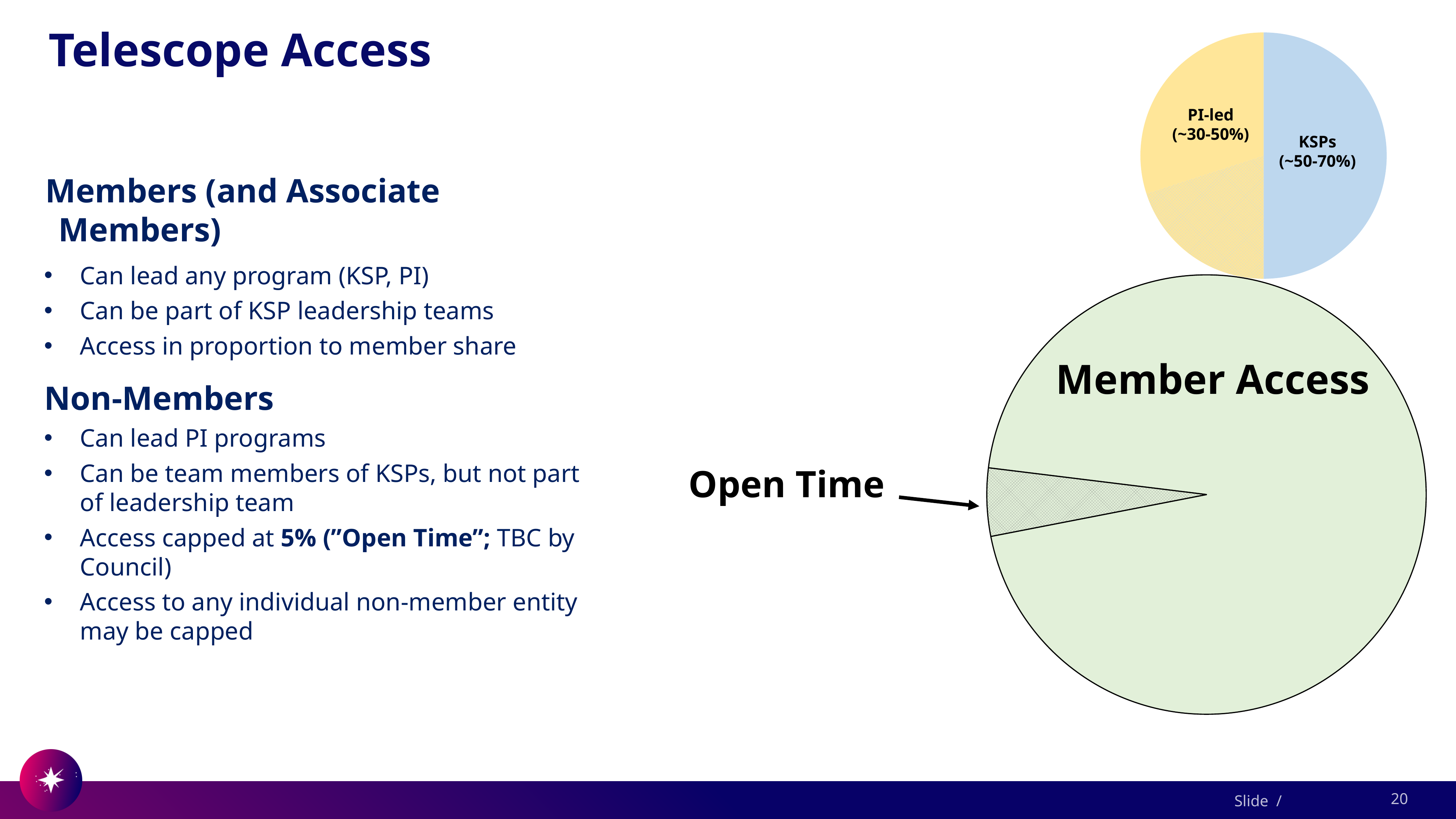
In the small pie chart at the top right, what colour is the KSPs slice? blue In the small pie chart at the top right, what colour is the PI-led slice? yellow In the small pie chart at the top right, how many slices are there? 3 What kind of chart is the small chart at the top right of the slide? pie chart In the small pie chart at the top right, which slice is larger, KSPs or PI-led? KSPs What kind of chart is the large chart labelled Member Access? pie chart In the small pie chart at the top right, which slice is the largest? KSPs In the large pie chart, which slice is the smallest? Open Time In the large pie chart, how many slices are there? 2 In the large pie chart, which slice is larger, Member Access or Open Time? Member Access